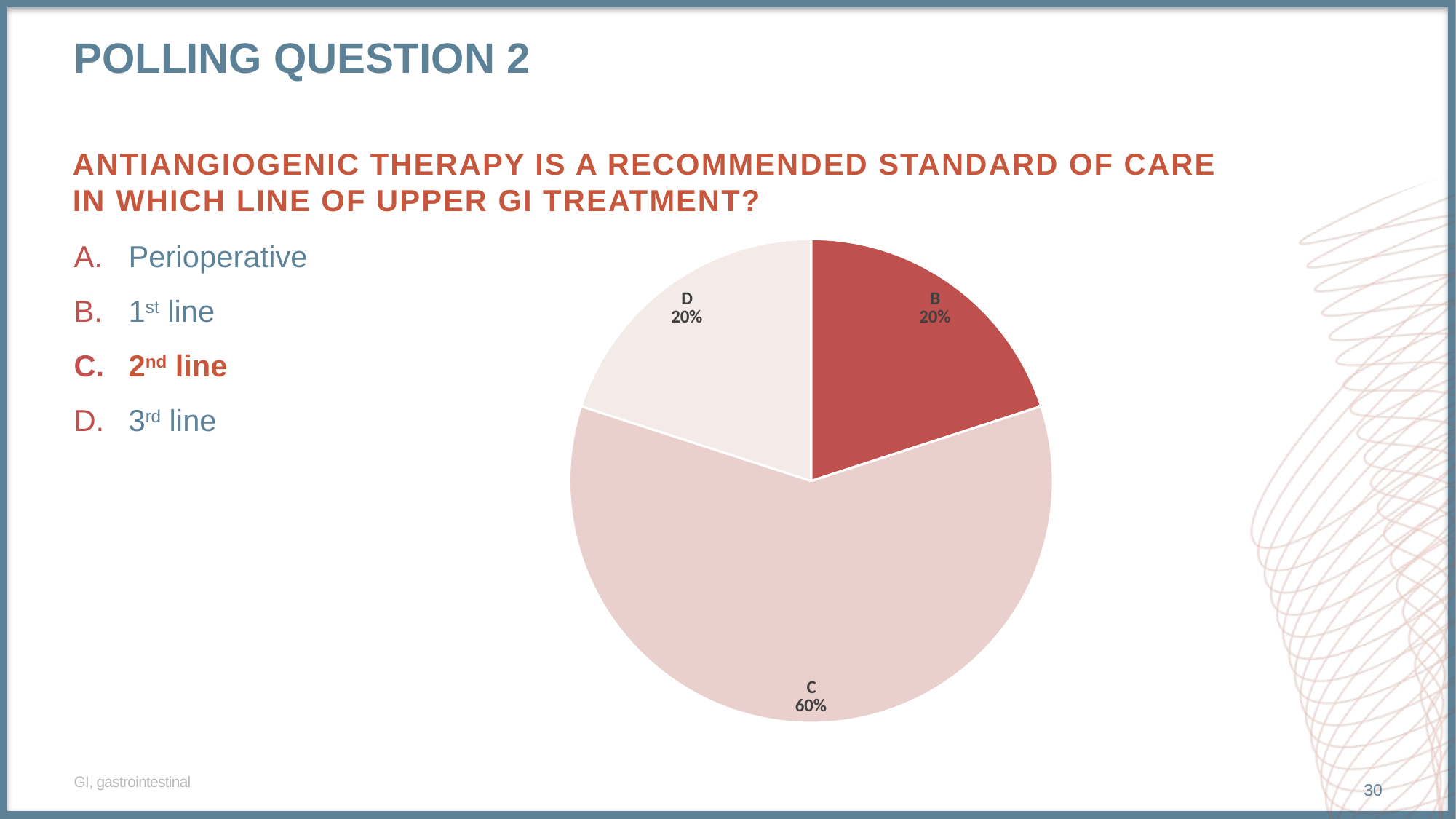
How many slices does the pie chart have? 3 Which answer option is highlighted in bold red as the correct answer on the slide? C. 2nd line Which is larger, slice C or slice D? C What is the combined percentage of slices B and D? 40% What percentage of the pie is labelled C? 60% Which slice of the pie chart is the largest? C Which slice of the pie chart is shown in the darkest red colour? B Is the share for slice C greater or less than 50%? greater What percentage of the pie is labelled D? 20% What is the difference in percentage points between slice C and slice B? 40 What percentage of the pie is labelled B? 20% What kind of chart is shown on the slide? pie chart